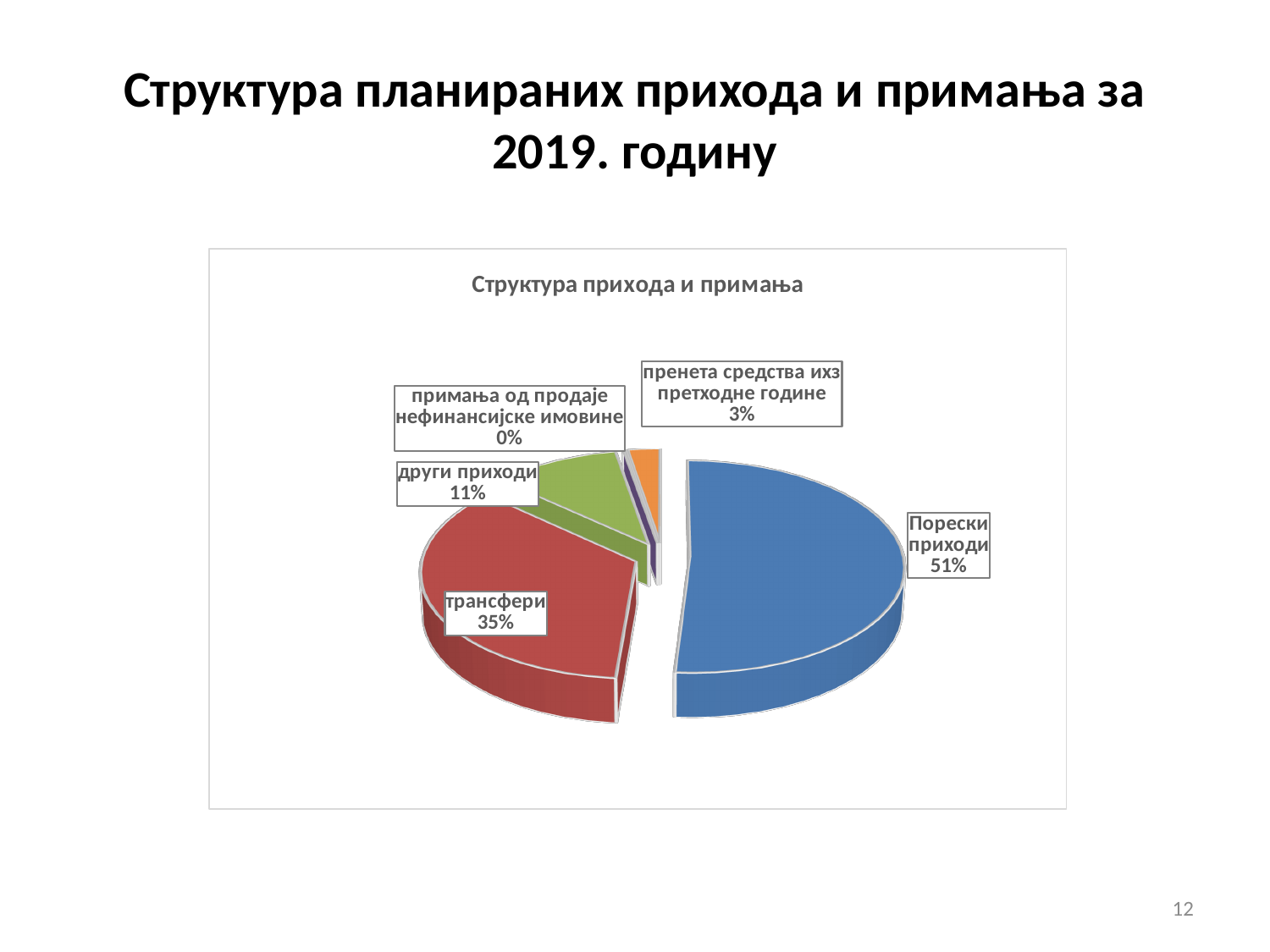
Which is larger, the share for други приходи or the share for пренета средства из претходне године? други приходи What share of the pie is labelled for пренета средства из претходне године? 3% Which category has the largest share of the pie? Порески приходи What share of the pie is labelled for други приходи? 11% What share of the pie is labelled for примања од продаје нефинансијске имовине? 0% What kind of chart is shown on the slide? pie chart Which category has the smallest share of the pie? примања од продаје нефинансијске имовине What is the title of the chart? Структура прихода и примања How many slices does the pie chart have? 5 What is the difference in percentage points between Порески приходи and трансфери? 16